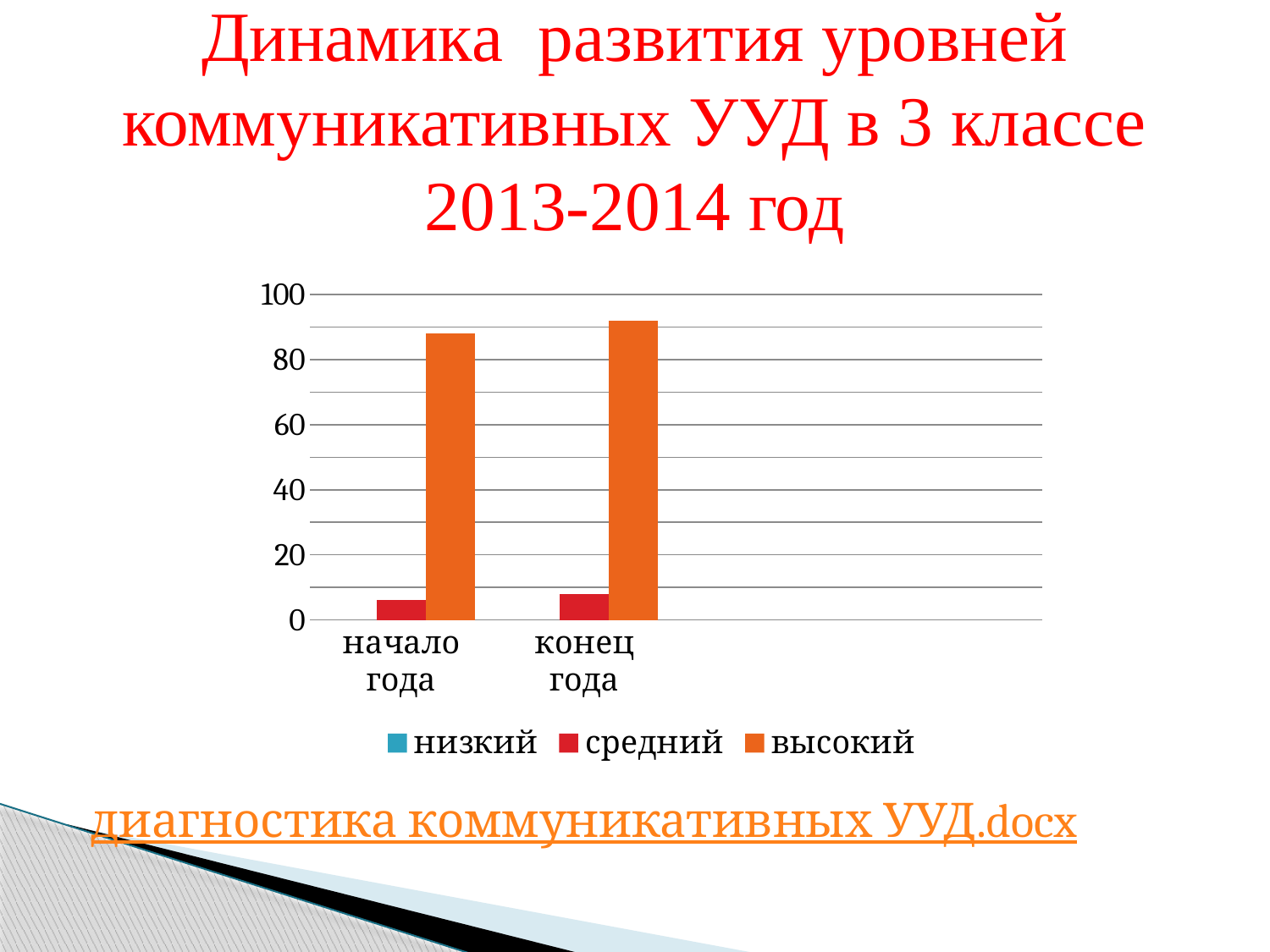
For the высокий series, is the value at конец года larger or smaller than at начало года? larger At начало года, which is larger: средний or высокий? высокий Is the value for средний at конец года greater or less than 20? less Is the value for высокий at начало года greater or less than 80? greater How many series does the chart legend list? 3 Is the value for средний at начало года greater or less than 20? less What kind of chart is shown on the slide? bar chart How many categories are shown on the x axis of the chart? 2 Does the высокий series rise or fall from начало года to конец года? rise Which series are listed in the chart legend? низкий, средний, высокий